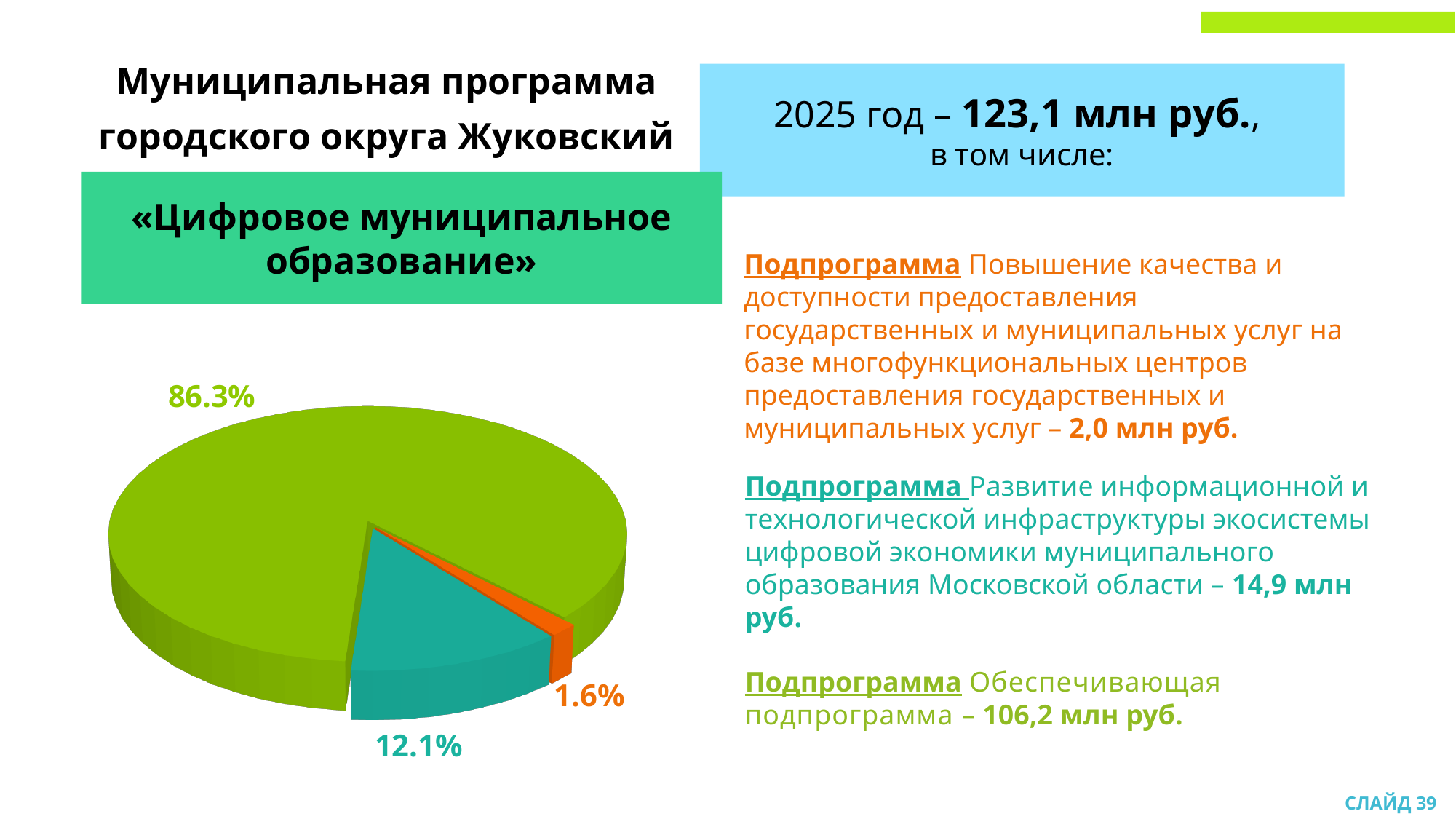
Which slice of the pie chart is the smallest? the orange slice (1.6%) Which slice of the pie chart is the largest? the green slice (86.3%) What percentage is shown for the teal slice of the pie chart? 12.1% What percentage is shown for the largest (green) slice of the pie chart? 86.3% Which is larger in the pie chart: the teal slice or the orange slice? the teal slice What colour is the slice labelled 12.1% in the pie chart? teal What is the difference in percentage points between the teal slice and the orange slice of the pie chart? 10.5 What percentage is shown for the orange slice of the pie chart? 1.6% What is the difference in percentage points between the green slice and the teal slice of the pie chart? 74.2 What colour is the slice labelled 86.3% in the pie chart? green How many slices does the pie chart have? 3 What kind of chart is shown on the slide? pie chart